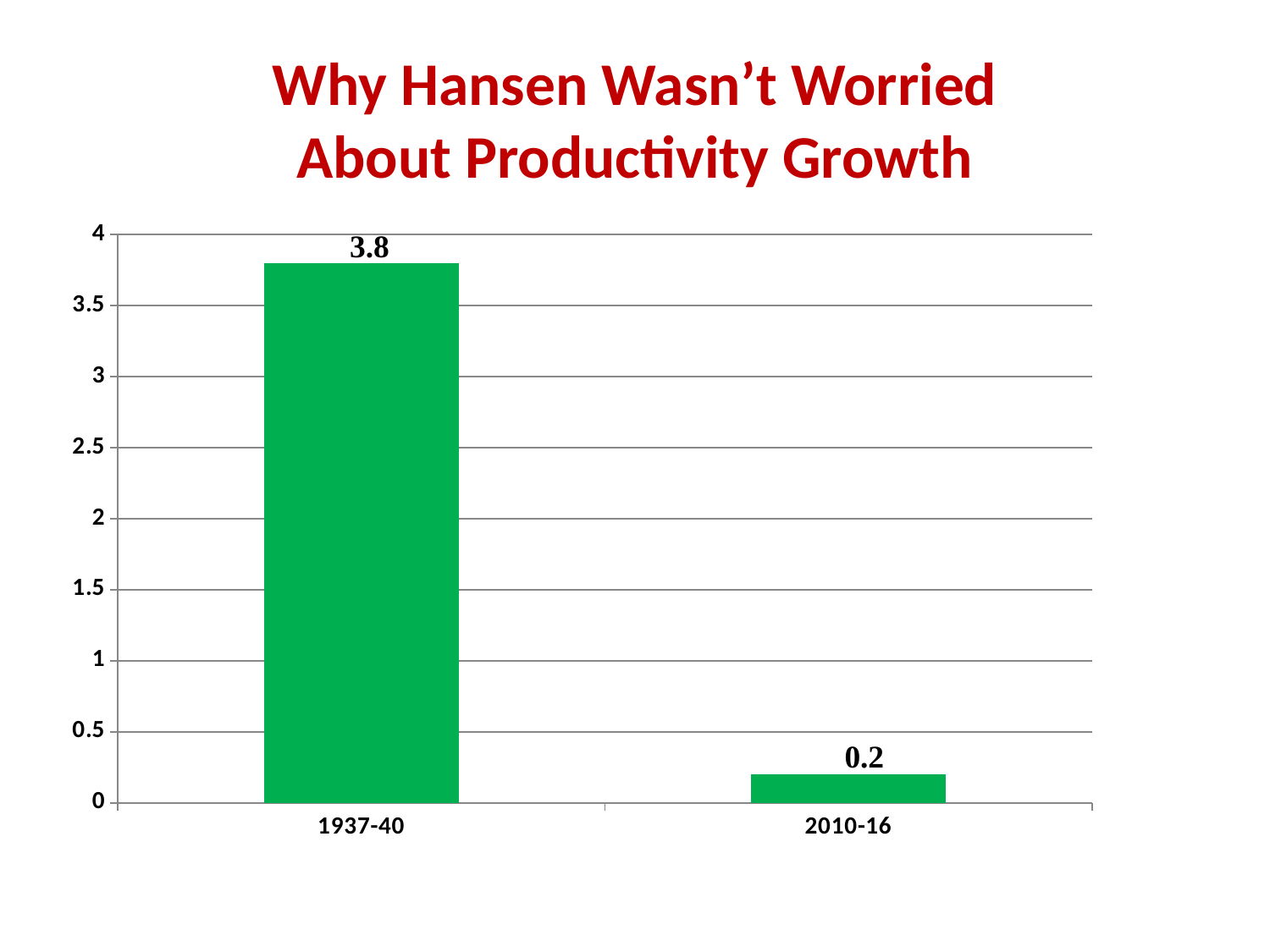
Is the value for 1937-40 greater or less than 3.5? greater What is the difference between the values for 1937-40 and 2010-16? 3.6 How many categories are shown on the x axis? 2 Which category has the highest value? 1937-40 What kind of chart is shown on the slide? bar chart What is the value for 2010-16? 0.2 Do the values rise or fall from 1937-40 to 2010-16? fall What is the title of the slide? Why Hansen Wasn't Worried About Productivity Growth Is the value for 2010-16 greater or less than 0.5? less Which category has the lowest value? 2010-16 What is the value for 1937-40? 3.8 Which is larger, the value for 1937-40 or the value for 2010-16? 1937-40